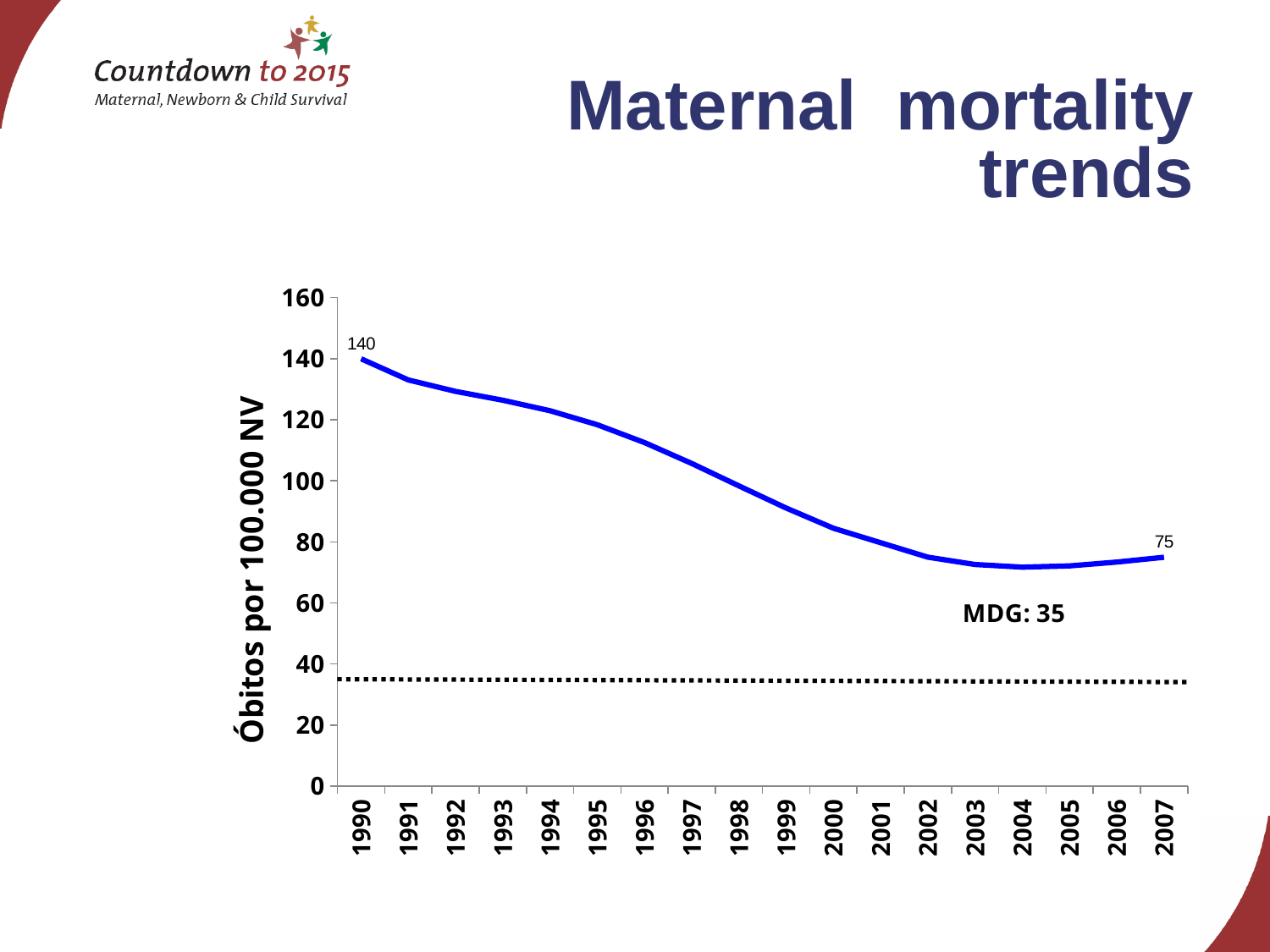
Do the values generally rise or fall from 1990 to 2007? fall Is the value for 1995 greater or less than 100? greater Is the value for 2004 greater or less than 80? less What is the difference between the value for 1990 and the value for 2007? 65 What is the value for 2007? 75 Is the value for 2000 greater or less than 100? less Which year has the highest value on the line? 1990 Which is larger, the value for 1990 or the value for 2007? 1990 What value does the dotted MDG line represent? 35 How many years are shown on the x axis? 18 What is the value for 1990? 140 What kind of chart is shown on the slide? line chart